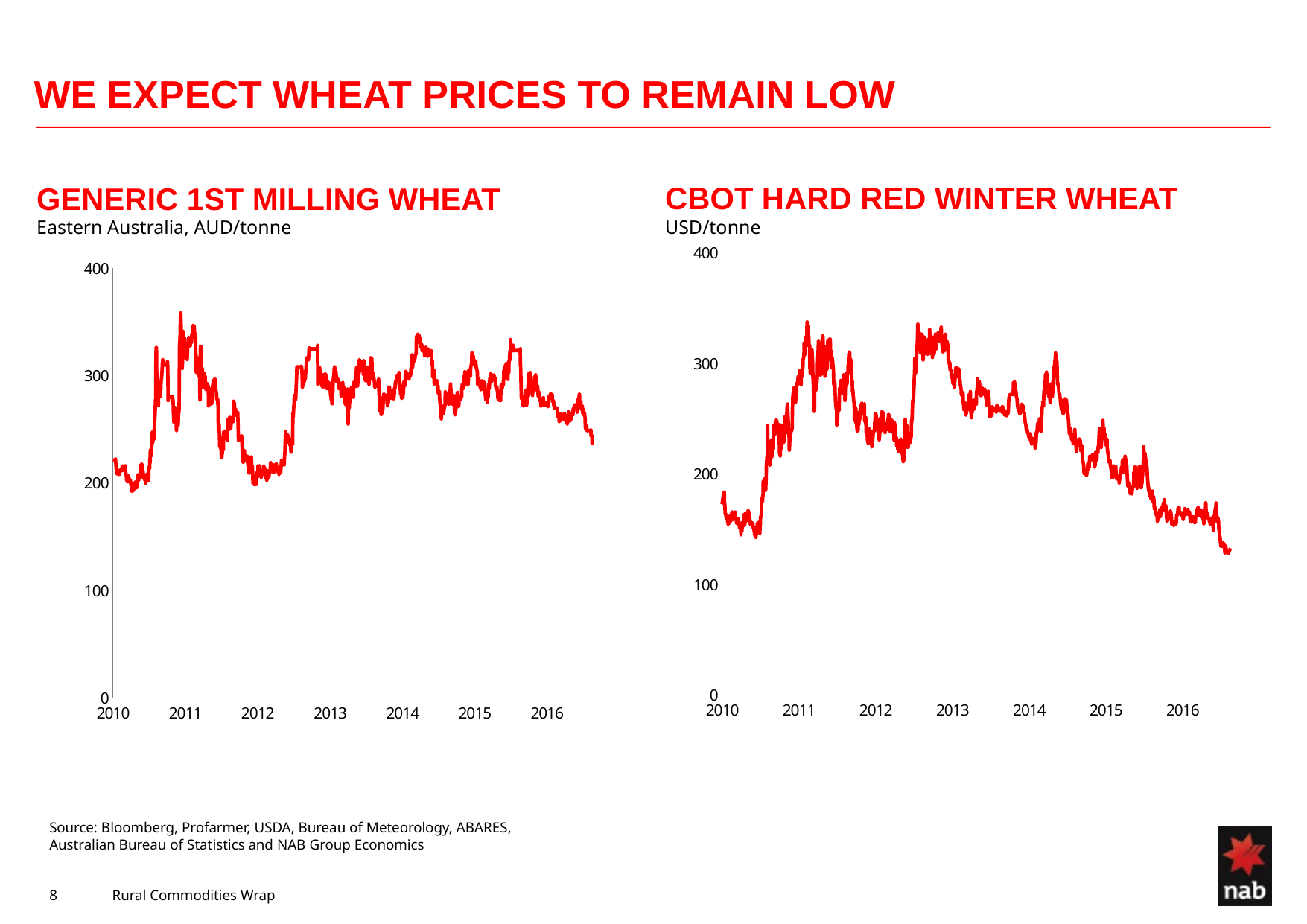
In the GENERIC 1ST MILLING WHEAT chart, is the value at the start of 2010 greater or less than 300? less In the GENERIC 1ST MILLING WHEAT chart, is the value at the end of the series in 2016 greater or less than 300? less In the CBOT HARD RED WINTER WHEAT chart, is the value at the start of 2010 greater or less than 200? less What kind of chart is the GENERIC 1ST MILLING WHEAT chart? line chart How many year labels are shown on the x axis of the GENERIC 1ST MILLING WHEAT chart? 7 In the CBOT HARD RED WINTER WHEAT chart, does the price generally rise or fall from 2014 to the end of 2016? fall What kind of chart is the CBOT HARD RED WINTER WHEAT chart? line chart In the GENERIC 1ST MILLING WHEAT chart, what unit is the price shown in? AUD/tonne In the CBOT HARD RED WINTER WHEAT chart, what unit is the price shown in? USD/tonne